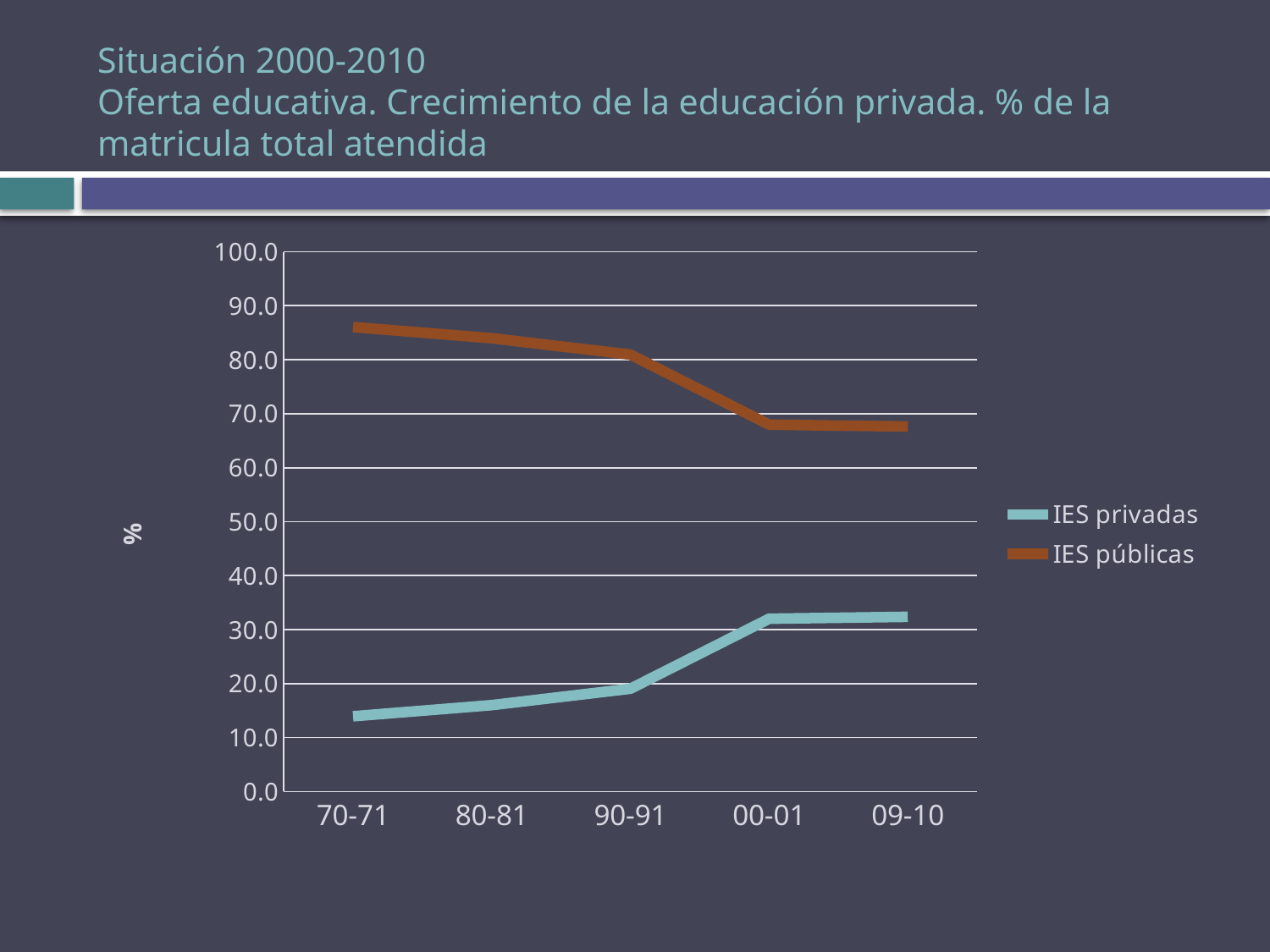
Does the IES privadas line rise or fall from 70-71 to 09-10? rise Which series has the higher value in 90-91, IES privadas or IES públicas? IES públicas How many series does the legend list? 2 In which period is the IES públicas value highest? 70-71 How many points are plotted along the x axis for each series? 5 Is the value for IES privadas in 70-71 greater or less than 20? less Is the value for IES públicas in 70-71 greater or less than 80? greater Does the IES públicas line rise or fall from 70-71 to 09-10? fall Is the value for IES públicas in 00-01 greater or less than 70? less What kind of chart is shown on the slide? line chart What is the label on the y axis? %